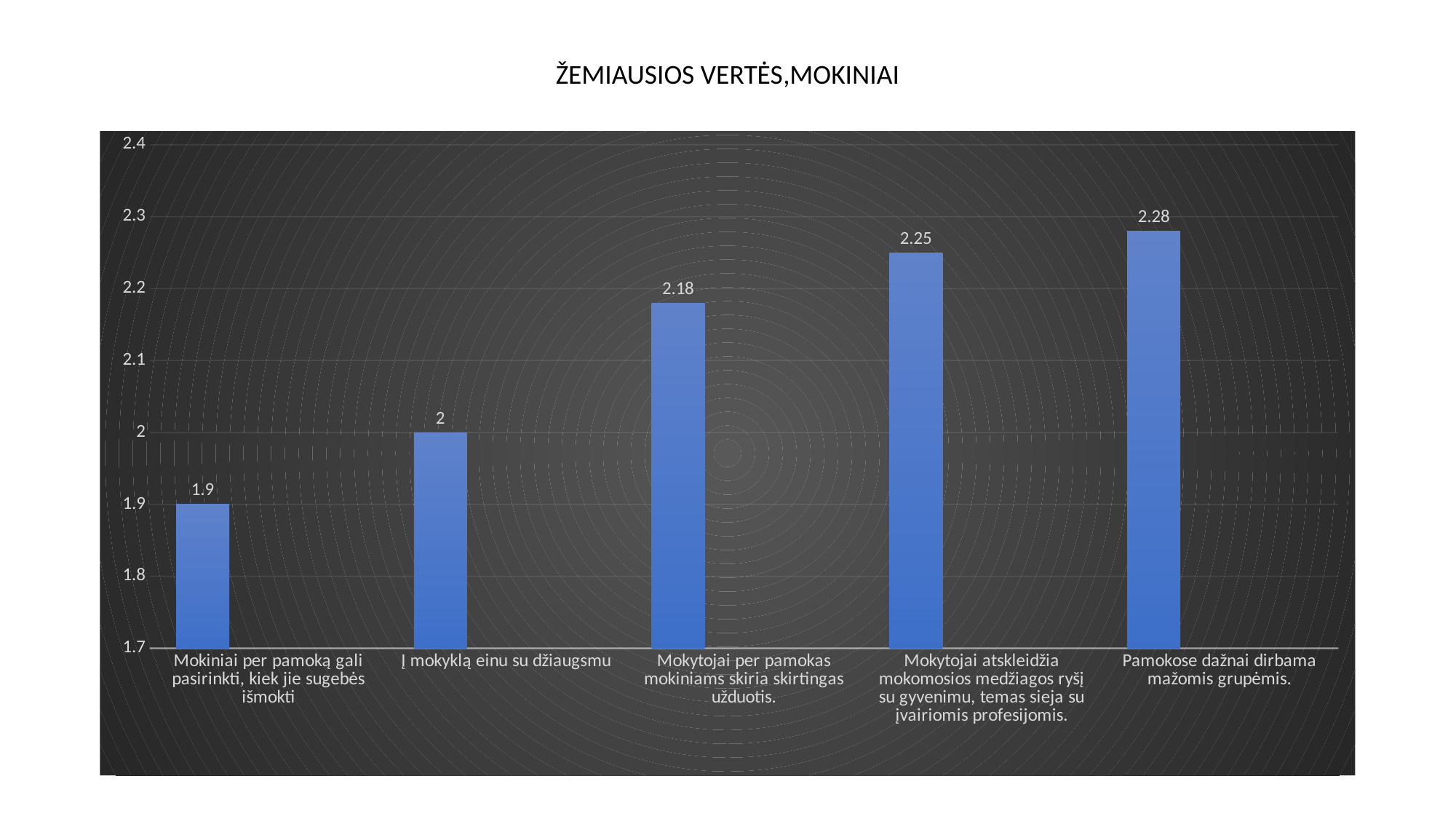
Do the values rise or fall from left to right along the x axis? rise How many categories are shown in the chart? 5 What is the value for "Mokytojai per pamokas mokiniams skiria skirtingas užduotis."? 2.18 Which category has the highest value? Pamokose dažnai dirbama mažomis grupėmis. Which is larger: the value for "Mokytojai atskleidžia mokomosios medžiagos ryšį su gyvenimu, temas sieja su įvairiomis profesijomis." or for "Mokytojai per pamokas mokiniams skiria skirtingas užduotis."? Mokytojai atskleidžia mokomosios medžiagos ryšį su gyvenimu, temas sieja su įvairiomis profesijomis. What is the value for "Į mokyklą einu su džiaugsmu"? 2 What kind of chart is shown on the slide? bar chart What is the difference between the values for "Pamokose dažnai dirbama mažomis grupėmis." and "Mokiniai per pamoką gali pasirinkti, kiek jie sugebės išmokti"? 0.38 What is the value for "Pamokose dažnai dirbama mažomis grupėmis."? 2.28 Which category has the lowest value? Mokiniai per pamoką gali pasirinkti, kiek jie sugebės išmokti What is the title of the chart? ŽEMIAUSIOS VERTĖS,MOKINIAI Is the value for "Mokiniai per pamoką gali pasirinkti, kiek jie sugebės išmokti" greater or less than 2? less